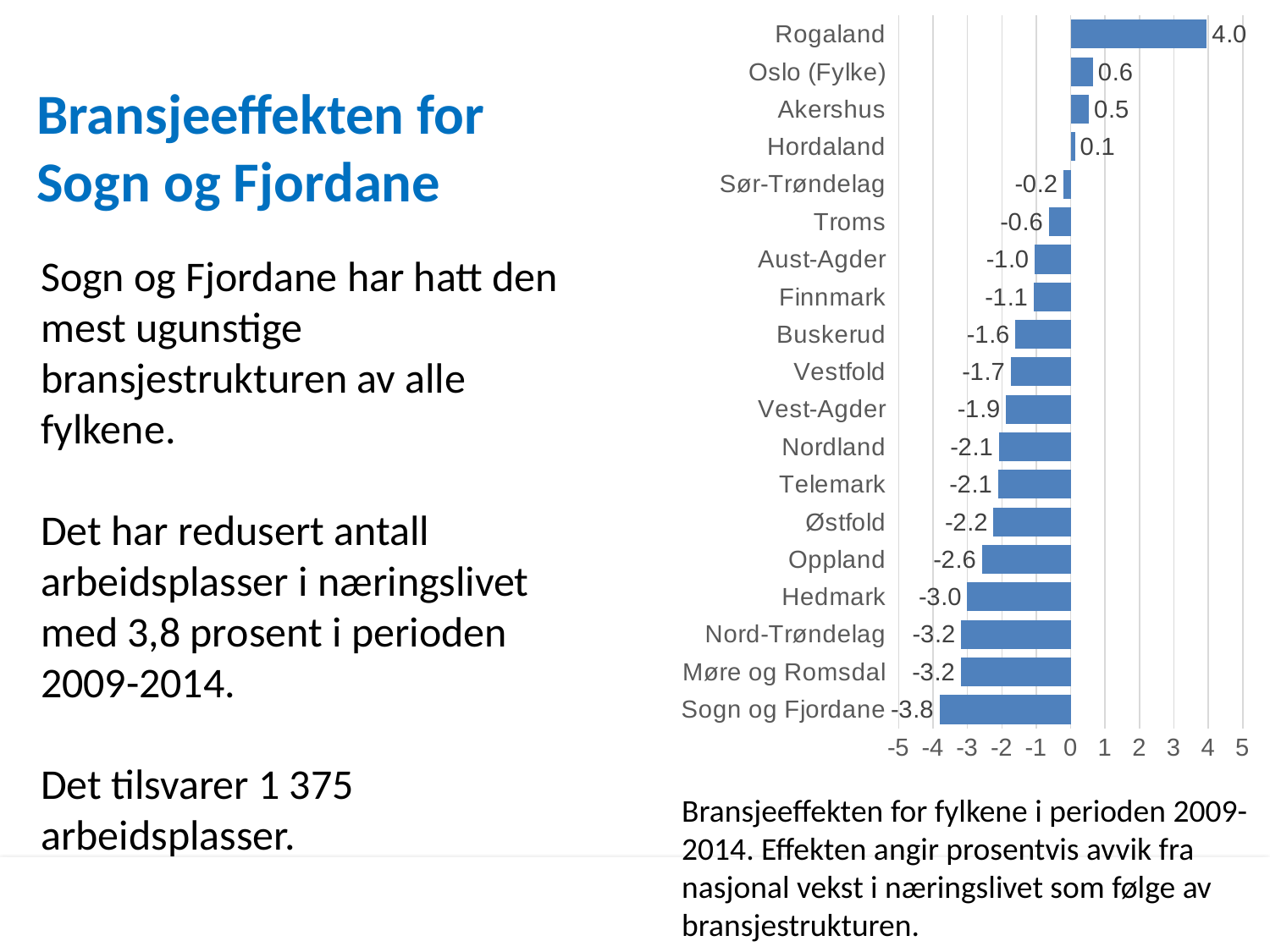
Which category has the lowest value? Sogn og Fjordane What is the value for Rogaland? 4.0 What is the value for Buskerud? -1.6 How many categories are shown in the chart? 19 What is the value for Hordaland? 0.1 What kind of chart is shown on the slide? bar chart How many categories have a positive value? 4 What is the difference between the values for Rogaland and Oslo (Fylke)? 3.4 Which has a larger value, Akershus or Troms? Akershus What is the value for Sogn og Fjordane? -3.8 Is the value for Hedmark greater or less than -2? less Which category has the highest value? Rogaland